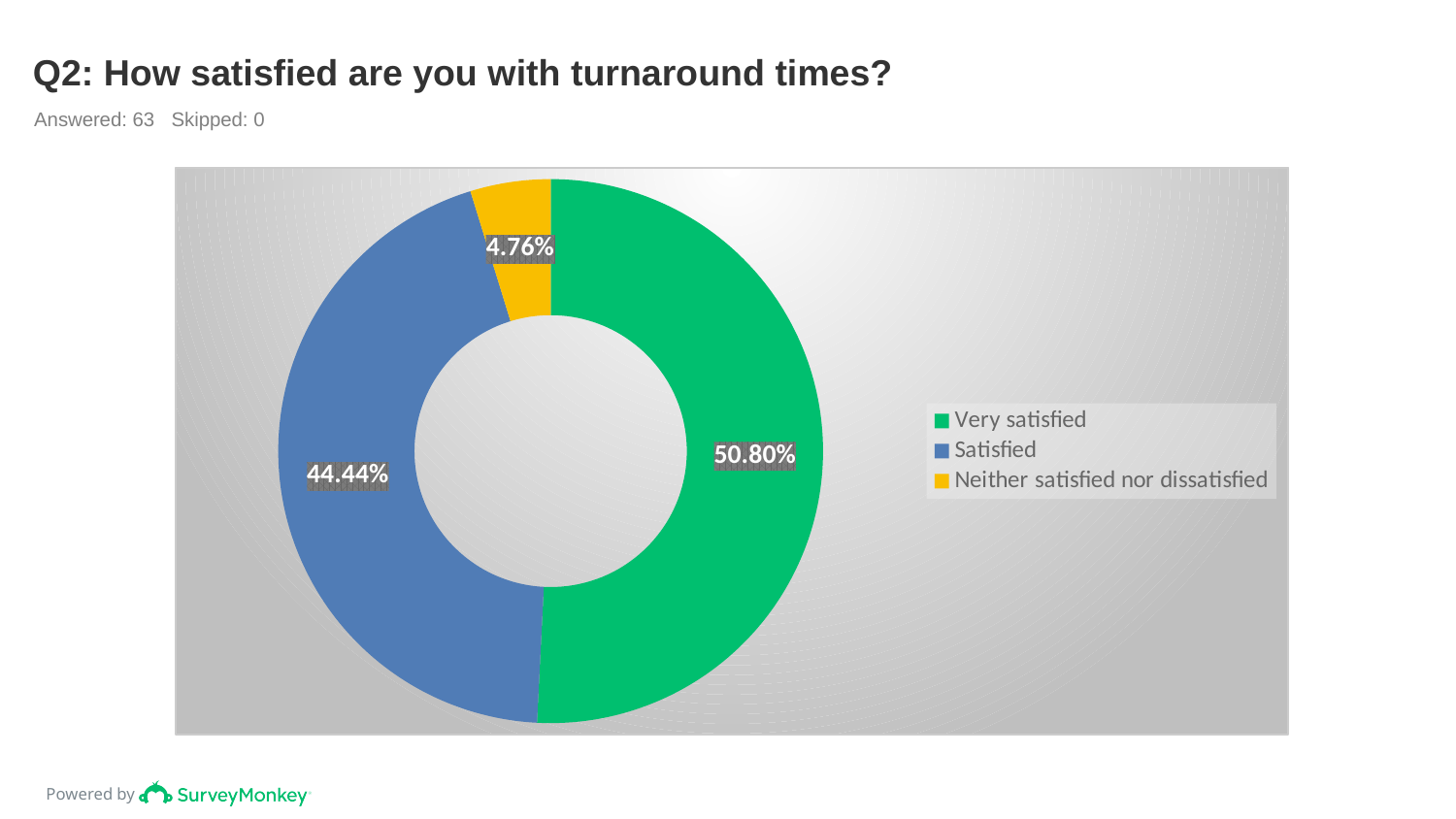
Which response category has the largest share of the pie? Very satisfied What is the difference in percentage points between "Satisfied" and "Neither satisfied nor dissatisfied"? 39.68 What colour represents "Satisfied" in the chart? Blue How many response categories are shown in the chart? 3 What kind of chart is shown on the slide? Pie chart (doughnut) Which is larger, the share for "Satisfied" or the share for "Neither satisfied nor dissatisfied"? Satisfied What percentage of respondents answered "Very satisfied"? 50.80% What percentage of respondents answered "Satisfied"? 44.44% What percentage of respondents answered "Neither satisfied nor dissatisfied"? 4.76% Which response category has the smallest share of the pie? Neither satisfied nor dissatisfied What is the difference in percentage points between "Very satisfied" and "Satisfied"? 6.36 How many respondents answered this question according to the slide? 63